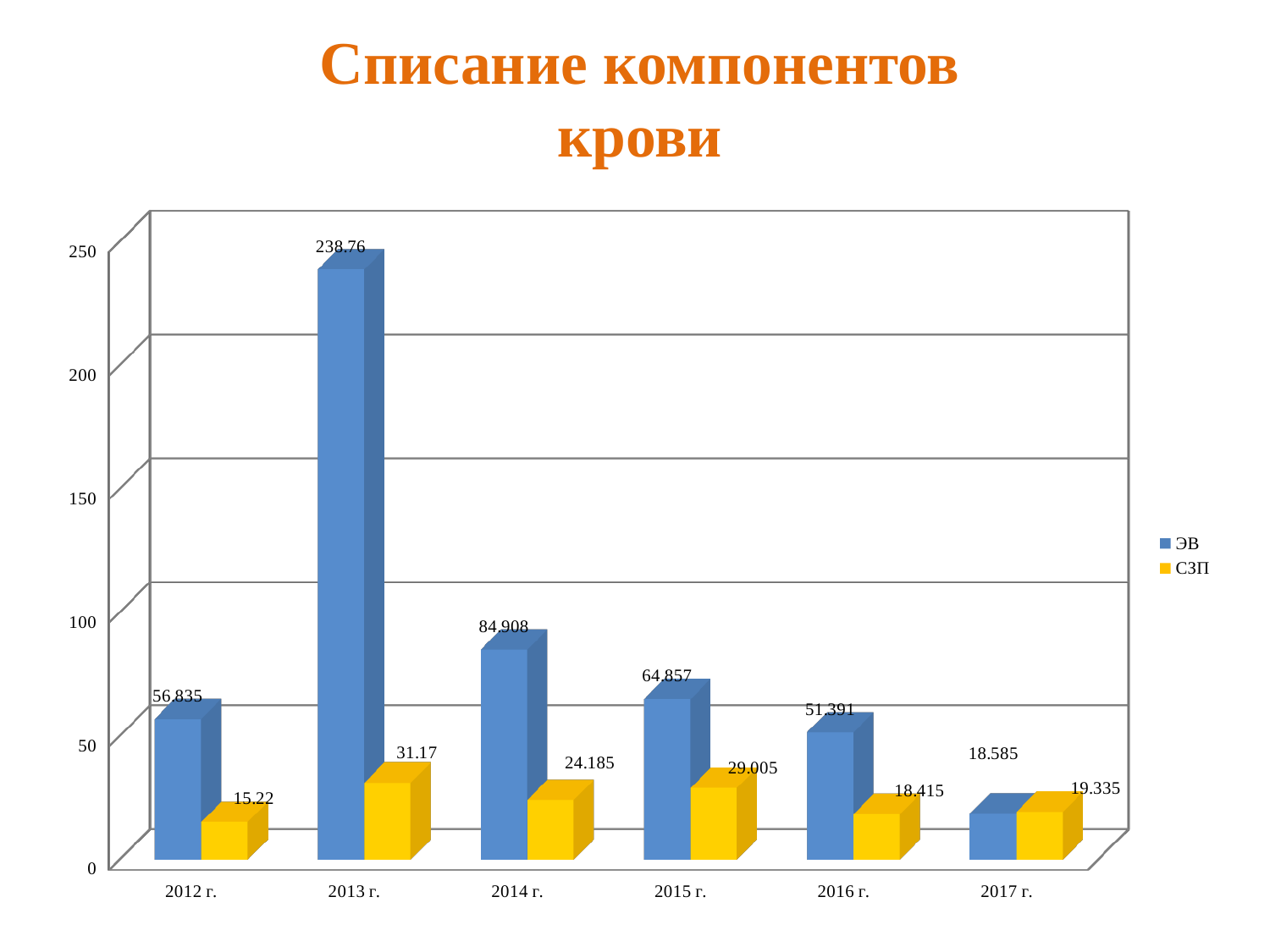
What is the difference between ЭВ in 2012 г. and ЭВ in 2016 г.? 5.444 What is the value for ЭВ in 2017 г.? 18.585 Which year has the highest value for ЭВ? 2013 г. In 2017 г., which series has the larger value, ЭВ or СЗП? СЗП What is the value for СЗП in 2015 г.? 29.005 What is the value for ЭВ in 2013 г.? 238.76 What kind of chart is shown on the slide? Bar chart How many years are shown on the x axis? 6 What is the difference between ЭВ and СЗП in 2013 г.? 207.59 Which year has the lowest value for СЗП? 2012 г. How many series does the legend list? 2 Do the values for ЭВ rise or fall from 2013 г. to 2017 г.? Fall